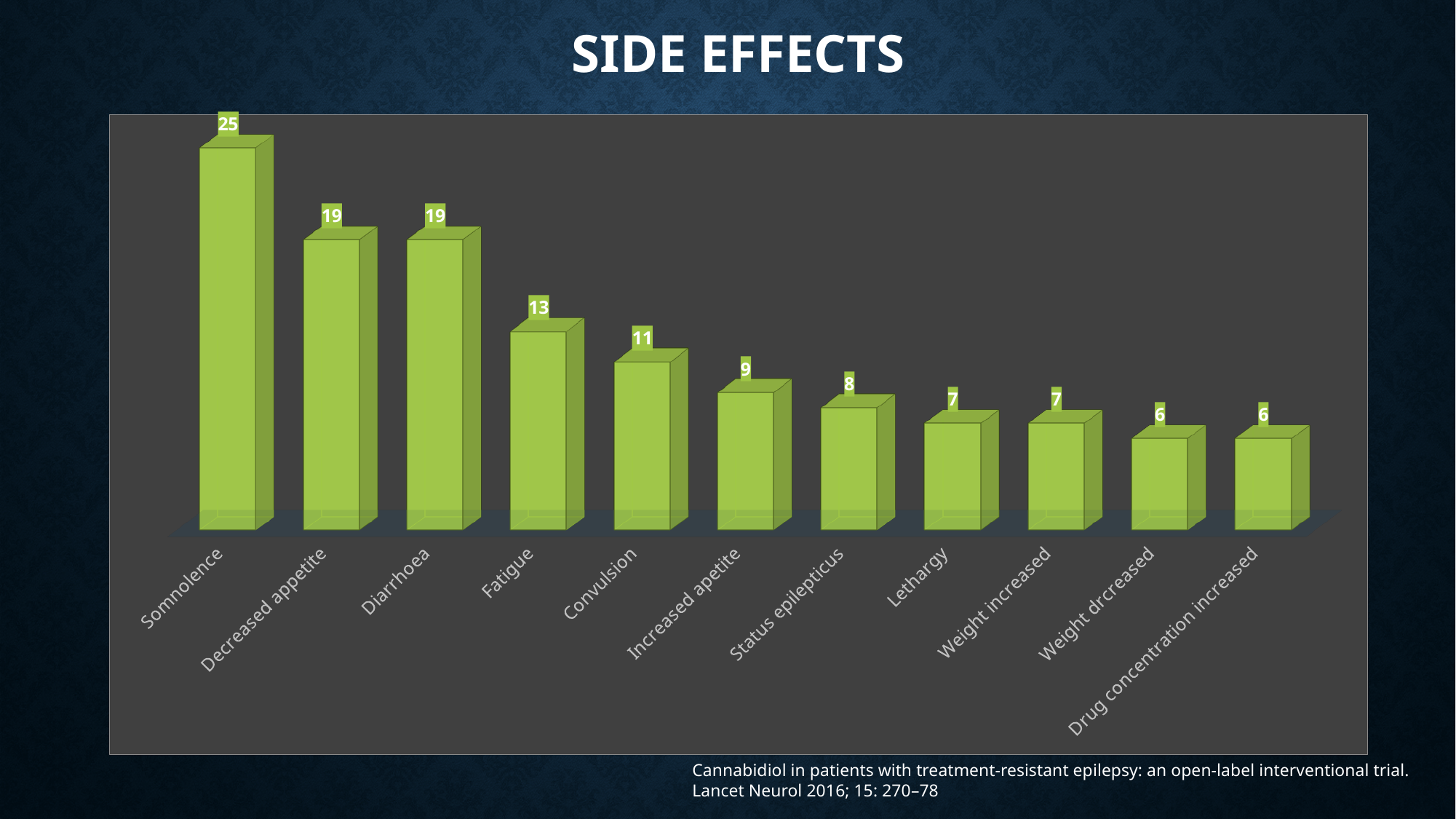
How many side effect categories are shown in the chart? 11 What is the difference between the values for Fatigue and Increased apetite? 4 Which is larger, the value for Decreased appetite or the value for Convulsion? Decreased appetite What kind of chart is shown on the slide? Bar chart What is the value for Status epilepticus? 8 What is the difference between the values for Somnolence and Diarrhoea? 6 What is the value for Somnolence? 25 What is the value for Fatigue? 13 Do the values rise or fall from left to right along the x axis? Fall What is the value for Convulsion? 11 Which side effect has the highest value? Somnolence What is the title of the slide? SIDE EFFECTS